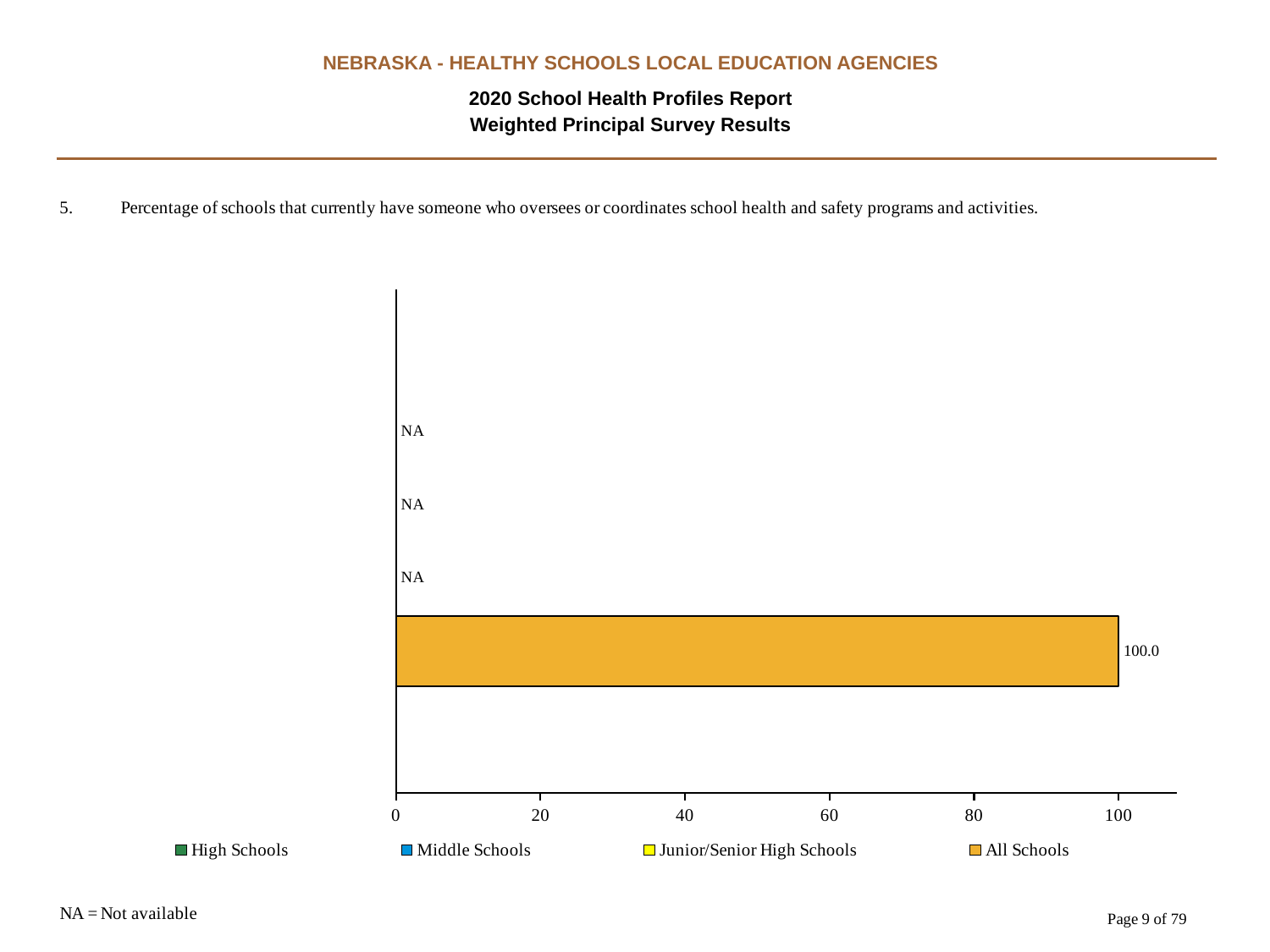
What is shown for Junior/Senior High Schools? NA Which series is the only one with a plotted bar? All Schools How many series are marked NA? 3 What kind of chart is shown on the slide? bar chart What does NA stand for according to the note on the slide? Not available What is shown for High Schools? NA What is the highest value shown on the x axis? 100 What is the value for All Schools? 100.0 How many series does the legend list? 4 What is shown for Middle Schools? NA Is the value for All Schools greater or less than 80? greater